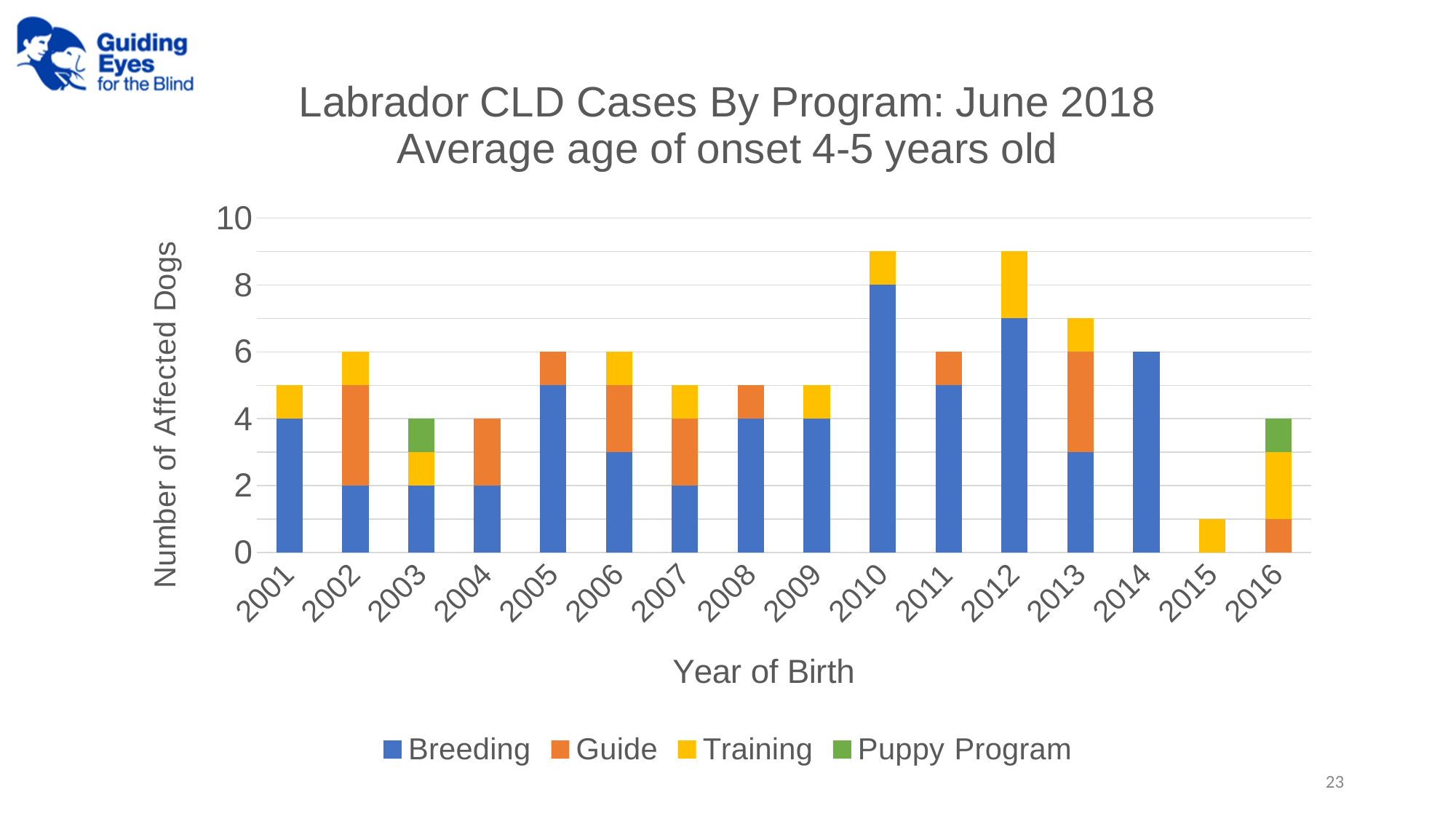
What is the Breeding value for 2012? 7 What kind of chart is shown on the slide? stacked bar chart What is the total number of affected dogs for the 2010 bar? 9 What is the difference between the total for 2010 and the total for 2015? 8 How many series does the legend list? 4 How many years of birth are shown on the x axis? 16 What is the total number of affected dogs for the 2013 bar? 7 Which year of birth has the highest Breeding value? 2010 Which has a larger total number of affected dogs, 2012 or 2013? 2012 Which series is shown in green in the legend? Puppy Program Which year of birth has the lowest total number of affected dogs? 2015 What is the Breeding value for 2014? 6